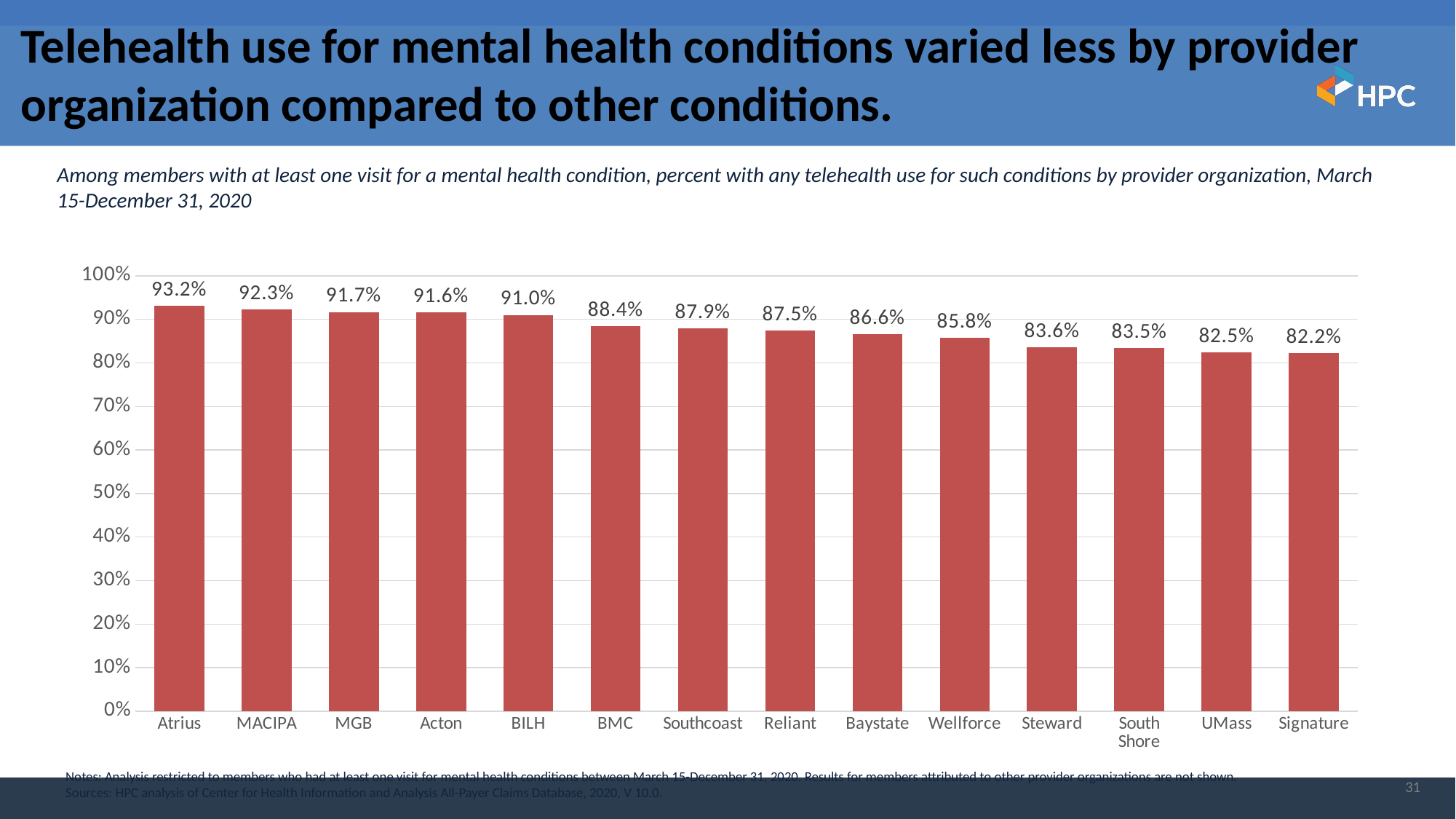
How many provider organizations are shown on the chart? 14 What is the difference between the values for BMC and Wellforce? 2.6% What is the difference between the values for Atrius and Signature? 11.0% What is the value for Atrius? 93.2% Is the value for UMass greater or less than 90%? less Which provider organization has the highest value? Atrius What is the value for Southcoast? 87.9% Which provider organization has the lowest value? Signature Which has a larger value, MGB or Steward? MGB What kind of chart is shown on the slide? bar chart What is the value for South Shore? 83.5% Do the values rise or fall moving from left to right along the x axis? fall